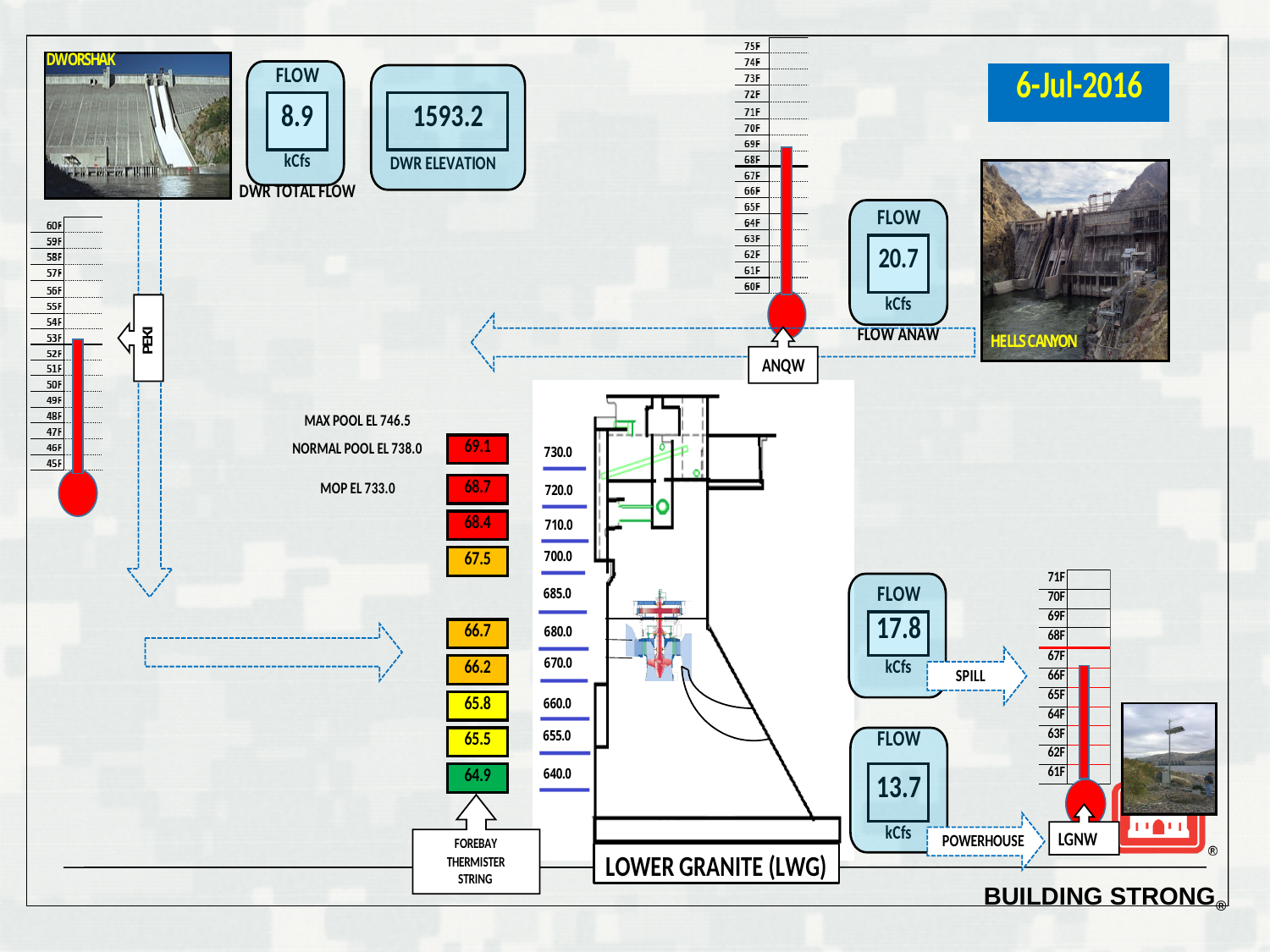
What is the difference between the highest (69.1) and lowest (64.9) readings in the forebay thermistor string? 4.2 What is the SPILL flow value shown for Lower Granite? 17.8 kCfs In the forebay thermistor string on the Lower Granite diagram, what is the lowest temperature reading shown? 64.9 Which is larger at Lower Granite, the SPILL flow or the POWERHOUSE flow? SPILL What is the DWR TOTAL FLOW value shown for Dworshak? 8.9 kCfs What is the POWERHOUSE flow value shown for Lower Granite? 13.7 kCfs On the ANQW thermometer gauge, is the temperature reading greater or less than 65F? greater In the forebay thermistor string on the Lower Granite diagram, what is the highest temperature reading shown? 69.1 What is the FLOW ANAW value shown on the slide? 20.7 kCfs How many temperature readings are shown in the forebay thermistor string? 9 Do the forebay thermistor string readings increase or decrease going from the top of the string to the bottom? decrease On the PEKI thermometer gauge, is the temperature reading greater or less than 55F? less